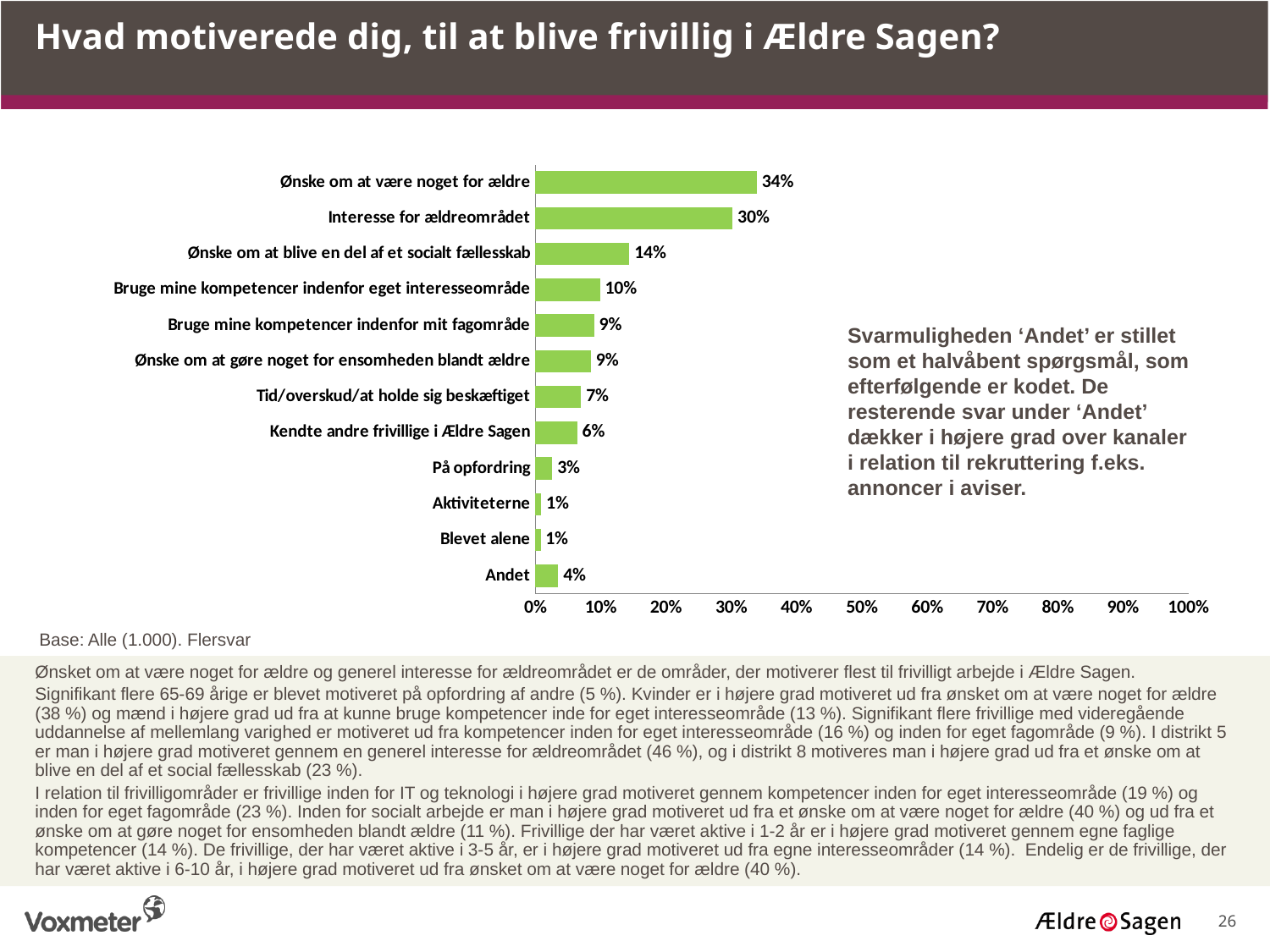
What is the maximum value shown on the x axis? 100% What is the value for "Andet"? 4% What is the value for "Kendte andre frivillige i Ældre Sagen"? 6% What is the value for "Ønske om at være noget for ældre"? 34% What kind of chart is shown on the slide? Bar chart What is the difference between "Ønske om at være noget for ældre" and "Interesse for ældreområdet"? 4% What is the value for "Interesse for ældreområdet"? 30% Is the value for "Interesse for ældreområdet" greater or less than 20%? greater How many categories are shown in the chart? 12 What is the difference between "Ønske om at blive en del af et socialt fællesskab" and "Bruge mine kompetencer indenfor eget interesseområde"? 4% Which is larger, "Tid/overskud/at holde sig beskæftiget" or "På opfordring"? Tid/overskud/at holde sig beskæftiget Which category has the highest value? Ønske om at være noget for ældre